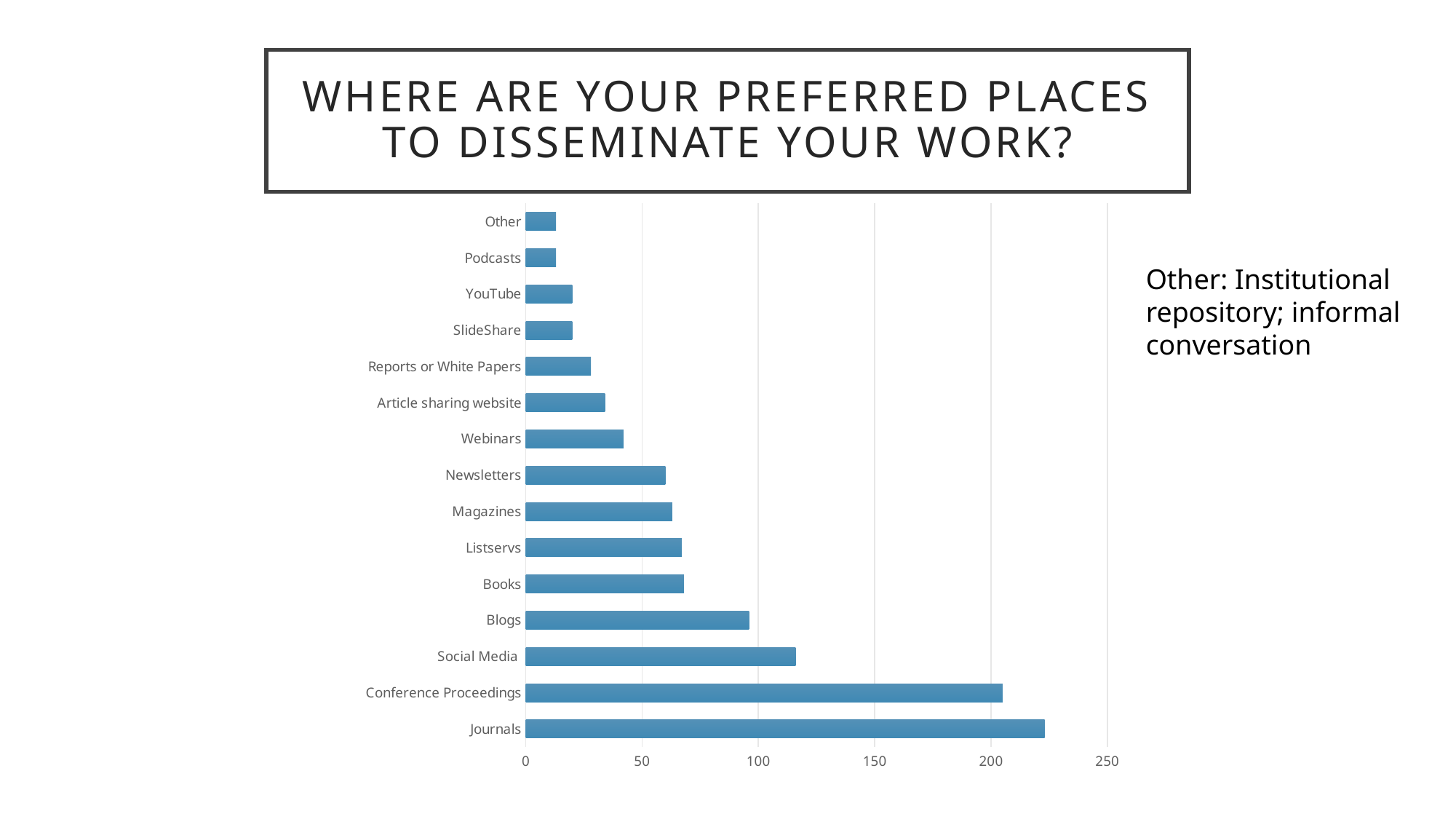
What is the title of the slide containing the chart? Where are your preferred places to disseminate your work? Which is larger, the value for Conference Proceedings or the value for Social Media? Conference Proceedings Is the value for Webinars greater or less than 50? less Which category has the highest value? Journals How many categories are plotted in the chart? 15 Is the value for Conference Proceedings greater or less than 200? greater Is the value for Journals greater or less than 200? greater Which is larger, the value for Social Media or the value for Blogs? Social Media What kind of chart is shown on the slide? bar chart